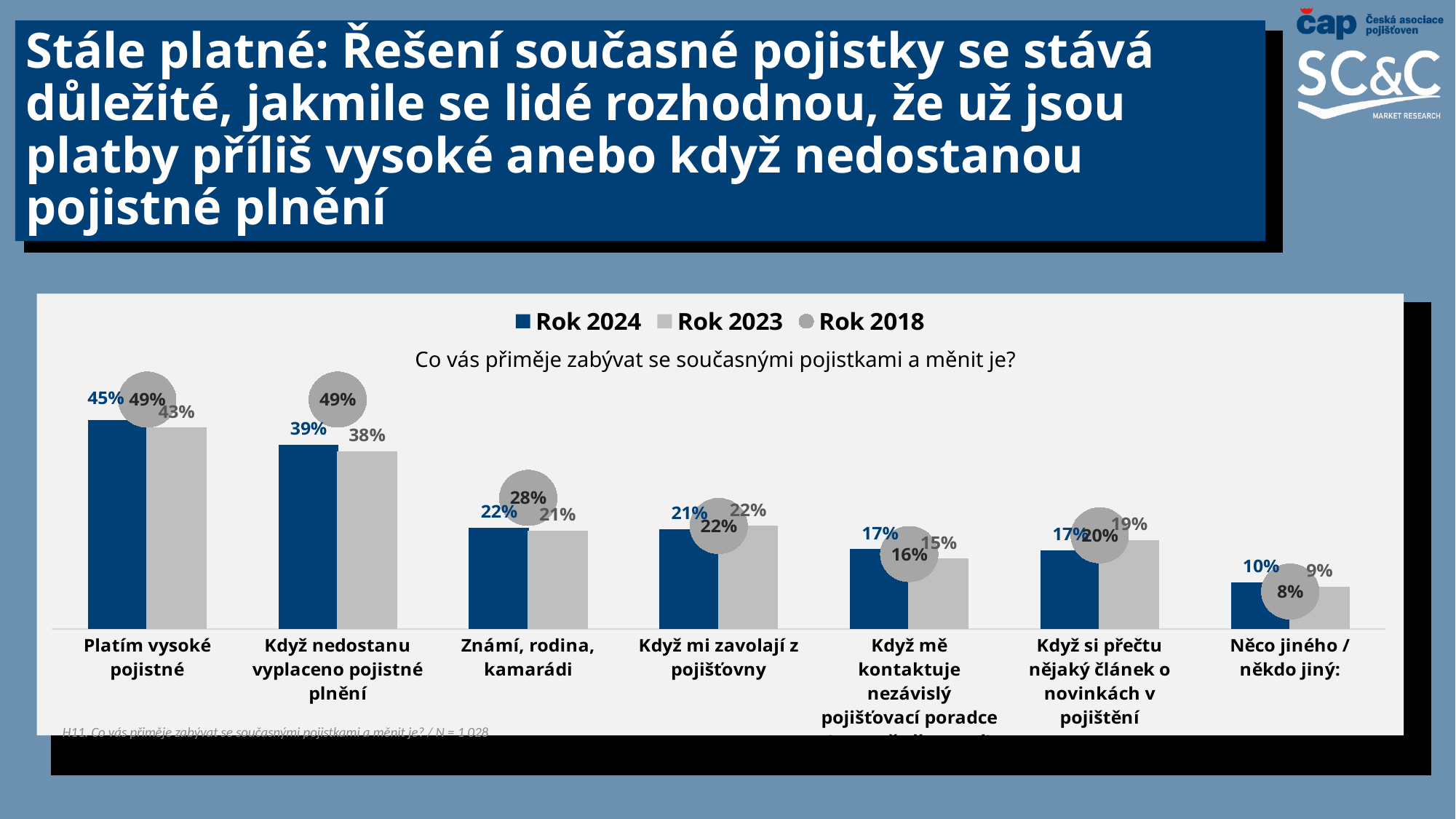
What is the Rok 2024 value for "Platím vysoké pojistné"? 45% Which category has the highest Rok 2024 value? Platím vysoké pojistné Which category has the lowest Rok 2023 value? Něco jiného / někdo jiný What is the Rok 2024 value for "Něco jiného / někdo jiný"? 10% What is the difference between the Rok 2018 and Rok 2024 values for "Když nedostanu vyplaceno pojistné plnění"? 10 percentage points How many categories are shown on the x axis of the chart? 7 What kind of chart is shown on the slide? Bar chart What is the Rok 2023 value for "Když nedostanu vyplaceno pojistné plnění"? 38% What is the Rok 2018 value for "Známí, rodina, kamarádi"? 28% For "Když si přečtu nějaký článek o novinkách v pojištění", which is larger: the Rok 2024 value or the Rok 2023 value? Rok 2023 What question is shown as the chart's subtitle? Co vás přiměje zabývat se současnými pojistkami a měnit je? How many series does the chart legend list? 3